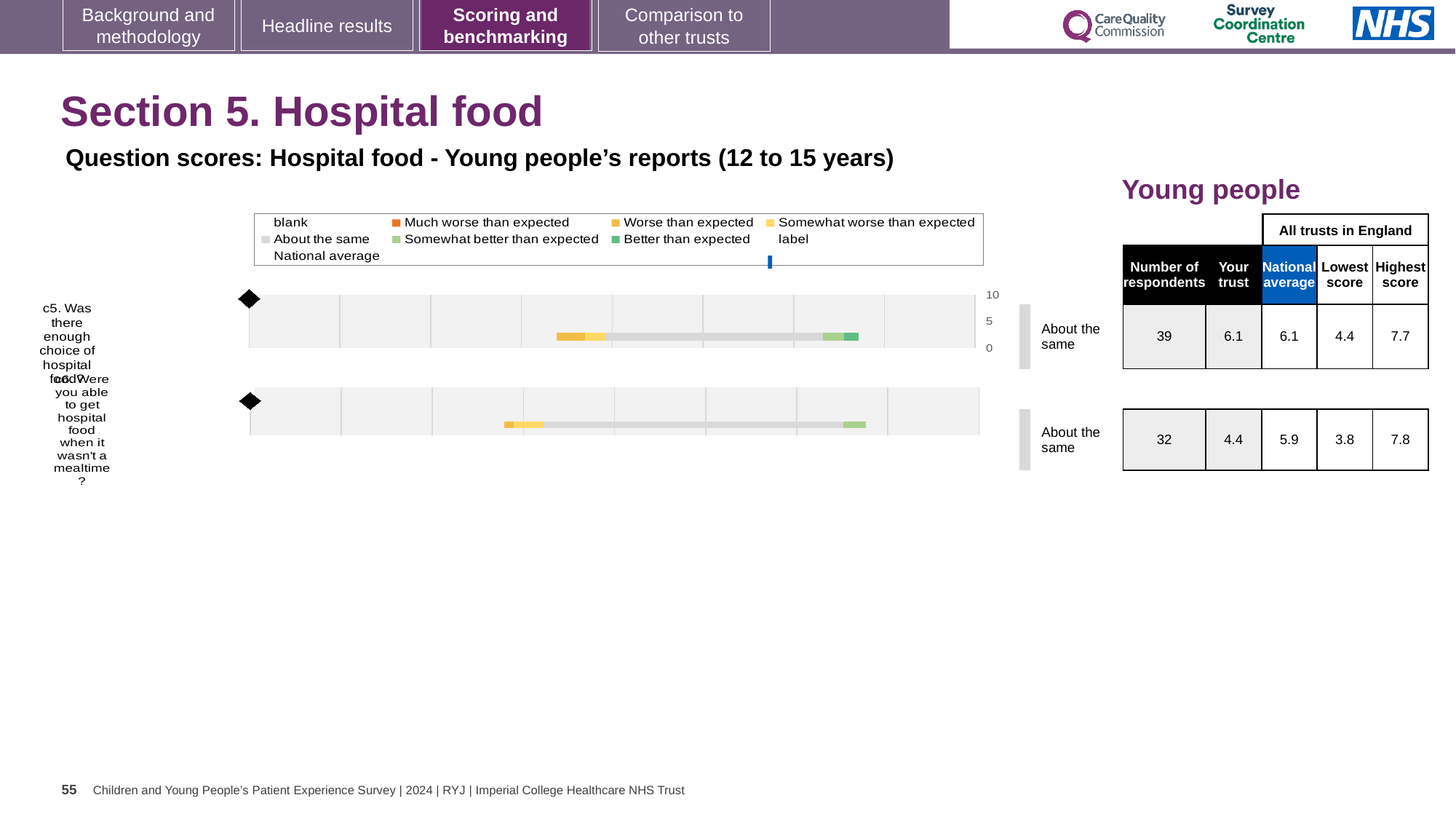
What kind of chart is used to show the question scores for hospital food? bar chart What is the difference in the number of respondents between question c5 and question c6? 7 What is the 'Your trust' score for question c6 'Were you able to get hospital food when it wasn't a mealtime?'? 4.4 What colour is the 'Better than expected' legend entry in the chart? green What is the difference between the national average and the 'Your trust' score for question c6? 1.5 What is the lowest score among all trusts in England for question c5? 4.4 For question c6, which is larger: the 'Your trust' score or the national average? National average What is the highest value shown on the chart's score axis? 10 What is the highest score among all trusts in England for question c6? 7.8 How many respondents answered question c5 'Was there enough choice of hospital food?'? 39 What is the national average score for question c5 'Was there enough choice of hospital food?'? 6.1 How many questions (categories) are plotted in the hospital food chart? 2